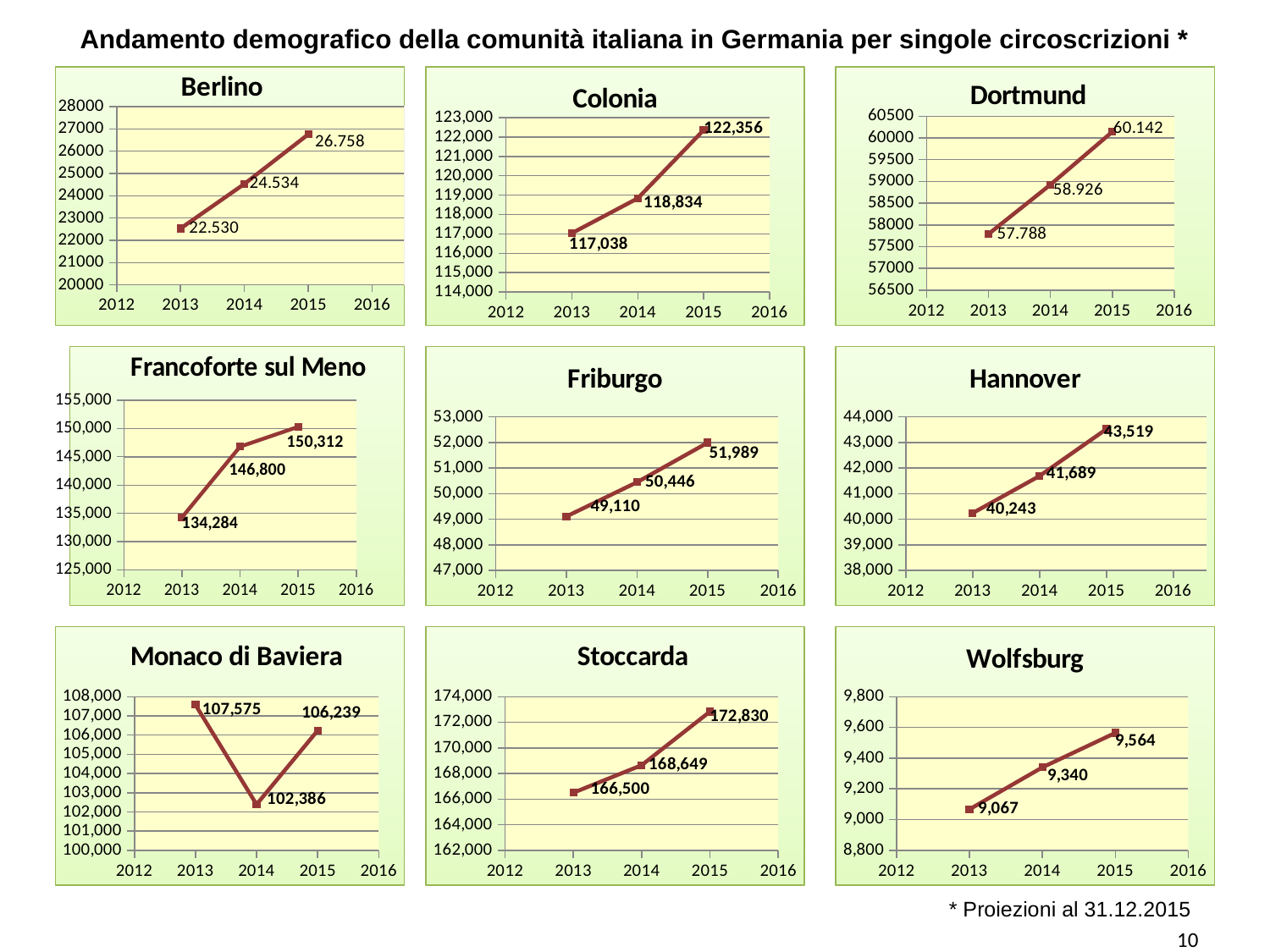
In the Monaco di Baviera chart, what is the difference between the 2013 and 2014 values? 5,189 In the Stoccarda chart, which year has the highest value? 2015 In the Dortmund chart, what is the value for 2014? 58.926 In the Francoforte sul Meno chart, is the value for 2014 larger or smaller than the value for 2015? smaller In the Colonia chart, what is the value for 2013? 117,038 In the Monaco di Baviera chart, which year has the lowest value? 2014 In the Hannover chart, do the values rise or fall from 2013 to 2015? rise How many data points are plotted in the Wolfsburg chart? 3 What kind of chart is the Stoccarda chart? line chart In the Berlino chart, what is the value for 2015? 26.758 How many charts are shown on the slide? 9 In the Friburgo chart, what is the difference between the 2015 and 2013 values? 2,879